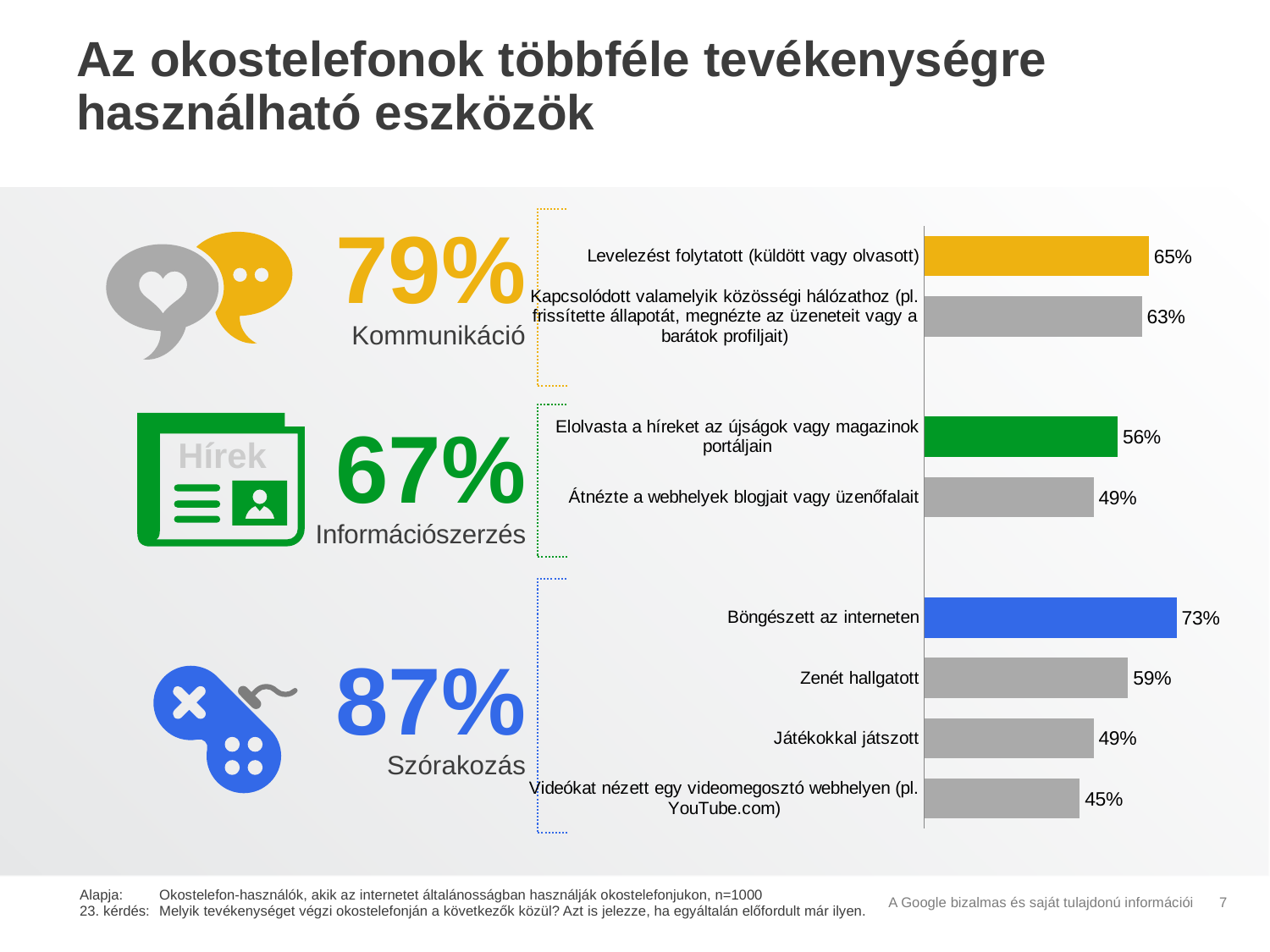
Which category has the highest value in the chart? Böngészett az interneten Which category has the lowest value in the chart? Videókat nézett egy videomegosztó webhelyen (pl. YouTube.com) What is the difference between the values for "Böngészett az interneten" and "Zenét hallgatott"? 14% What is the value for "Zenét hallgatott"? 59% What percentage is shown next to the "Szórakozás" label on the slide? 87% How many categories (bars) are shown in the chart? 8 What is the value for "Böngészett az interneten"? 73% What is the difference between the values for "Levelezést folytatott (küldött vagy olvasott)" and "Kapcsolódott valamelyik közösségi hálózathoz"? 2% What is the value for "Levelezést folytatott (küldött vagy olvasott)"? 65% What is the value for "Elolvasta a híreket az újságok vagy magazinok portáljain"? 56% What kind of chart is shown on the slide? Bar chart Which is larger: the value for "Elolvasta a híreket az újságok vagy magazinok portáljain" or the value for "Átnézte a webhelyek blogjait vagy üzenőfalait"? Elolvasta a híreket az újságok vagy magazinok portáljain